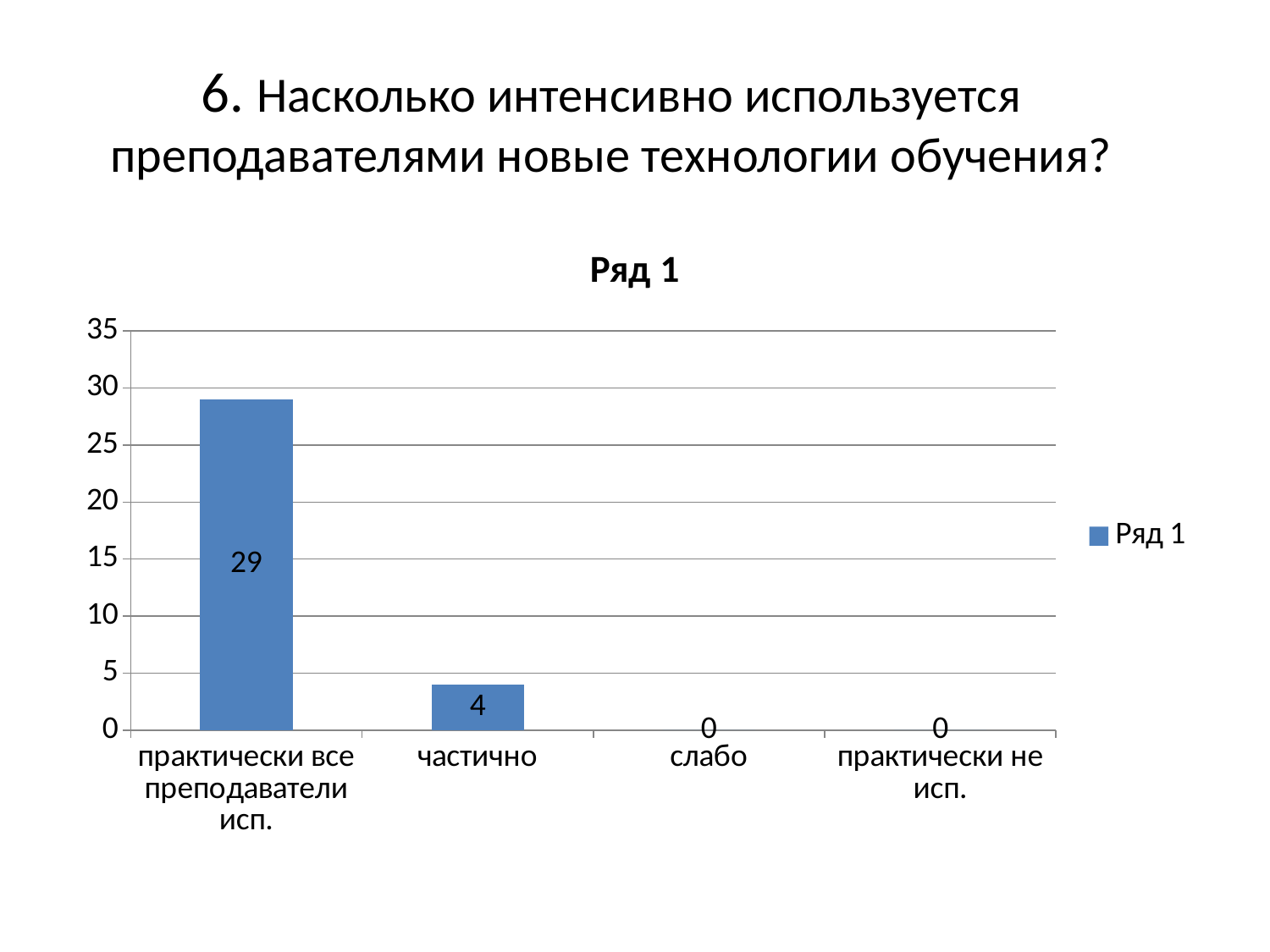
What is the value for "слабо"? 0 Which is larger, the value for "частично" or the value for "слабо"? частично Is the value for "практически все преподаватели исп." greater or less than 25? greater What is the value for "практически все преподаватели исп."? 29 What is the title of the chart? Ряд 1 What is the value for "практически не исп."? 0 What is the difference between the values for "практически все преподаватели исп." and "частично"? 25 What kind of chart is shown? bar chart Which category has the highest value? практически все преподаватели исп. How many series does the legend list? 1 What is the value for "частично"? 4 How many categories are shown on the x axis? 4